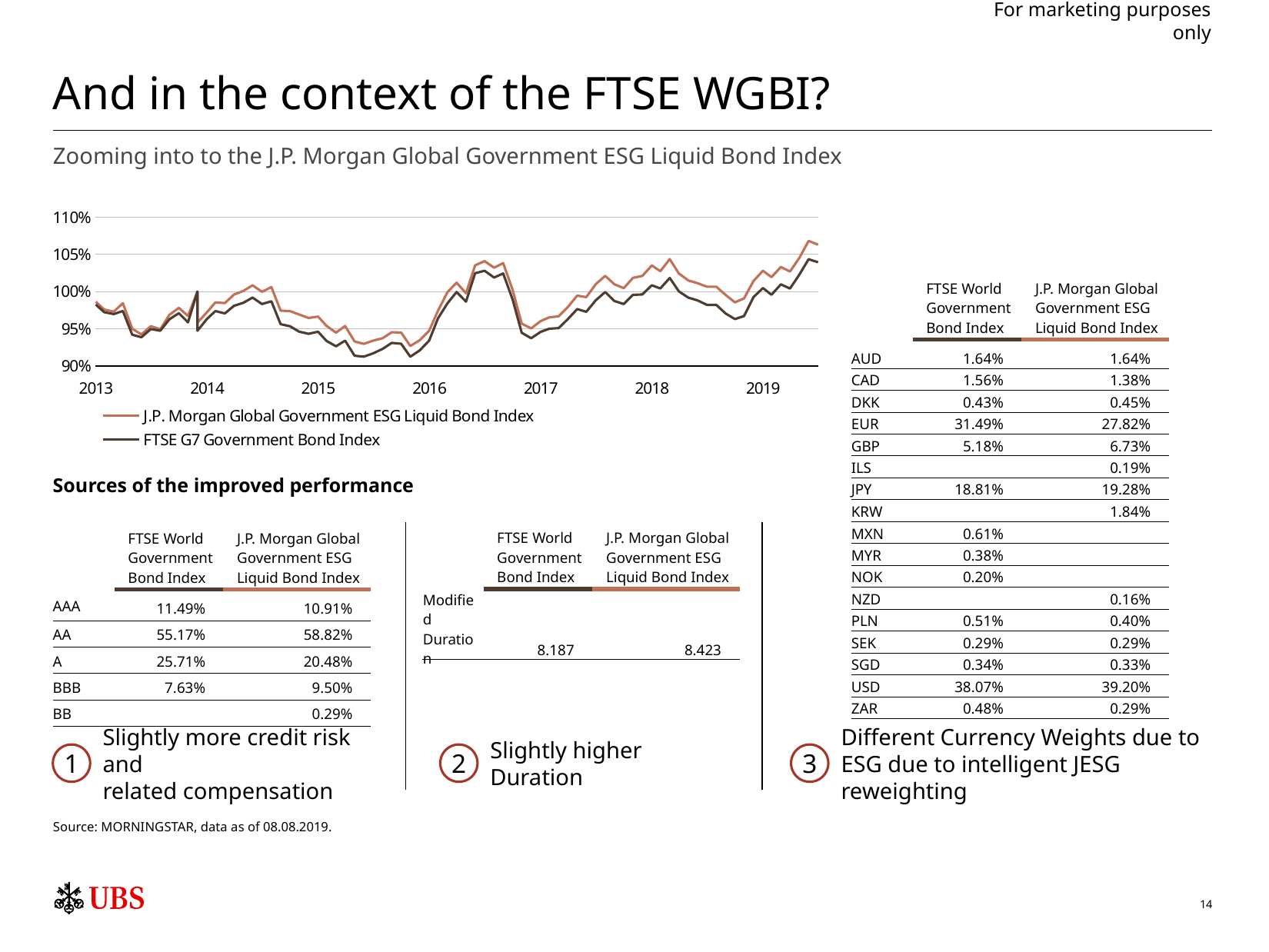
What kind of chart is shown on the slide? line chart How many series does the chart's legend list? 2 Is the lowest point of the FTSE G7 Government Bond Index line (around 2015-2016) greater or less than 95%? less Is the value of the J.P. Morgan Global Government ESG Liquid Bond Index at the end of the chart (2019) greater or less than 105%? greater Between 2016 and 2017, does the FTSE G7 Government Bond Index line rise or fall after its peak in 2016? fall What is the lowest value shown on the chart's y axis? 90% Overall from 2013 to 2019, does the J.P. Morgan Global Government ESG Liquid Bond Index line rise or fall? rise At the end of the chart in 2019, which series is higher: the J.P. Morgan Global Government ESG Liquid Bond Index or the FTSE G7 Government Bond Index? J.P. Morgan Global Government ESG Liquid Bond Index How many year labels are shown on the chart's x axis? 7 What are the two series named in the chart's legend? J.P. Morgan Global Government ESG Liquid Bond Index and FTSE G7 Government Bond Index Is the value of the FTSE G7 Government Bond Index at the end of the chart (2019) greater or less than 105%? less